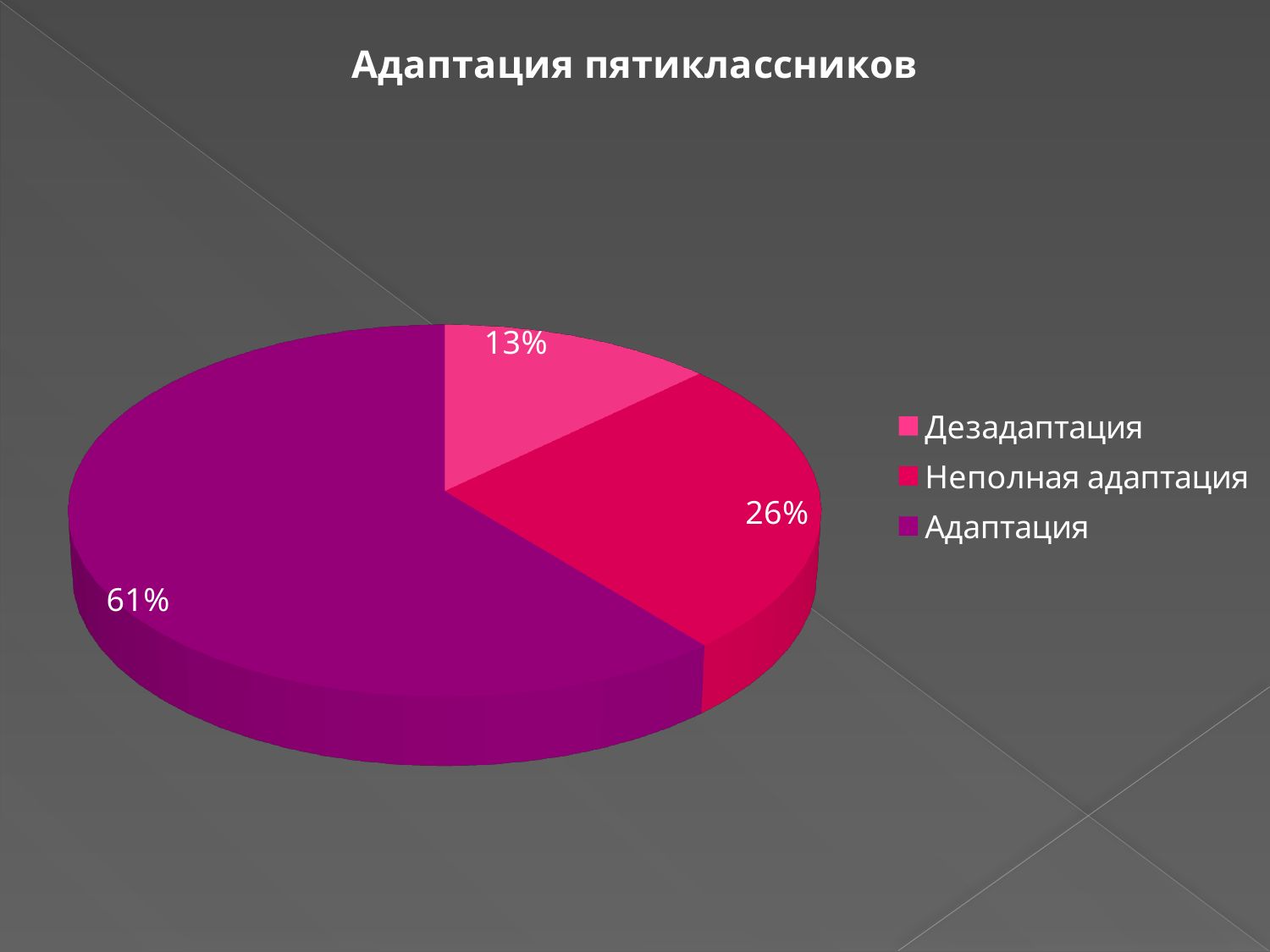
Which category has the largest slice of the pie? Адаптация What is the value shown for Неполная адаптация? 26% How many categories does the pie chart show? 3 What is the difference between the shares for Неполная адаптация and Дезадаптация? 13% What kind of chart is shown on the slide? Pie chart Which category has the smallest slice of the pie? Дезадаптация Which legend entry is shown in the darkest purple colour? Адаптация What is the value shown for Дезадаптация? 13% What share of the pie does Адаптация represent? 61% What is the difference between the shares for Адаптация and Неполная адаптация? 35% Which is larger, the share for Неполная адаптация or the share for Дезадаптация? Неполная адаптация What is the title of the chart? Адаптация пятиклассников